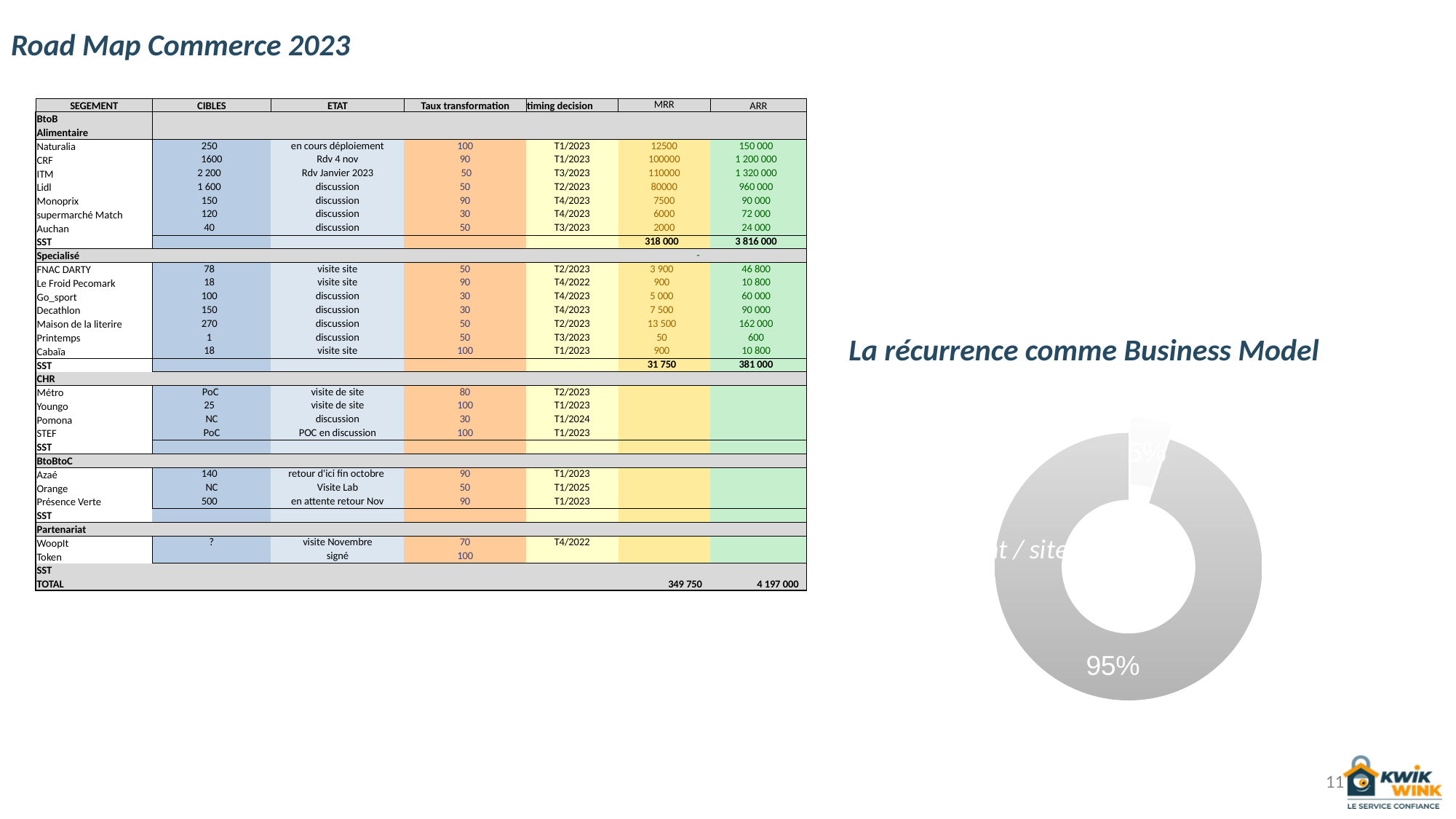
What kind of chart is shown on the right side of the slide? pie chart (doughnut) In the doughnut chart on the right, what share of the whole does the large grey slice represent? 95% In the doughnut chart on the right, what percentage is shown on the largest slice? 95% What is the heading written above the doughnut chart on the right? La récurrence comme Business Model How many slices does the doughnut chart on the right have? 2 In the doughnut chart on the right, what percentage is shown on the small slice? 5% In the doughnut chart on the right, is the small slice greater or less than 10%? less What colour are the slices of the doughnut chart on the right? grey In the doughnut chart on the right, is the largest slice greater or less than 50%? greater